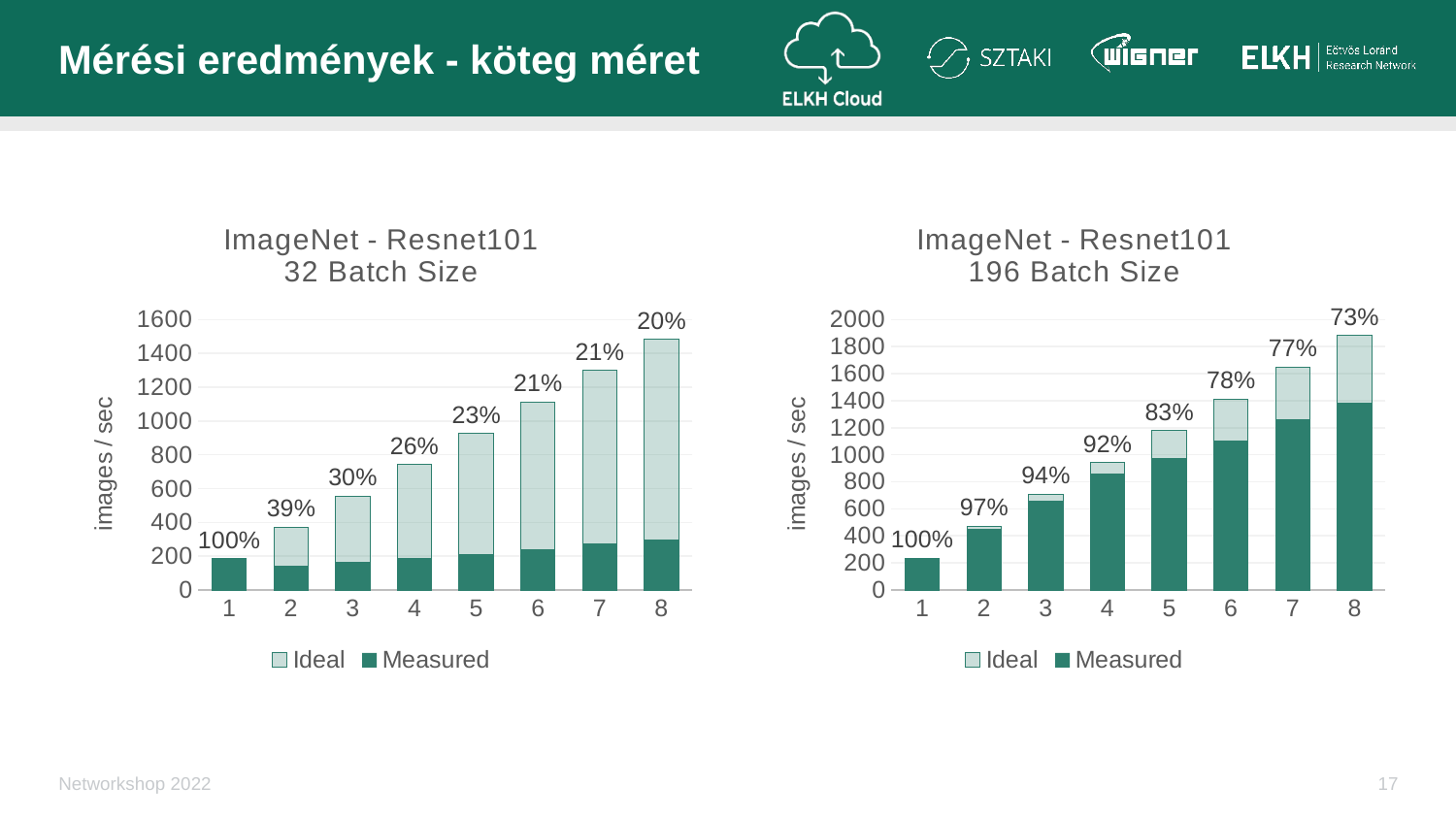
In the 'ImageNet - Resnet101 32 Batch Size' chart, do the percentage labels rise or fall as the category number increases from 1 to 8? fall In the 'ImageNet - Resnet101 196 Batch Size' chart, which has the higher percentage label, category 4 or category 6? Category 4 What kind of chart is the 'ImageNet - Resnet101 32 Batch Size' chart? Bar chart In the 'ImageNet - Resnet101 32 Batch Size' chart, what is the difference between the percentage labels for category 2 and category 3? 9% In the 'ImageNet - Resnet101 32 Batch Size' chart, what percentage label is shown above the bar for category 2? 39% What are the two legend entries in the 'ImageNet - Resnet101 196 Batch Size' chart? Ideal and Measured In the 'ImageNet - Resnet101 196 Batch Size' chart, which category has the lowest percentage label? 8 How many categories are shown on the x axis of the 'ImageNet - Resnet101 32 Batch Size' chart? 8 In the 'ImageNet - Resnet101 196 Batch Size' chart, is the Measured value for category 8 greater or less than 1200? greater In the 'ImageNet - Resnet101 196 Batch Size' chart, what percentage label is shown above the bar for category 5? 83% How many series does the legend of the 'ImageNet - Resnet101 196 Batch Size' chart list? 2 In the 'ImageNet - Resnet101 32 Batch Size' chart, is the total height of the stacked bar for category 8 greater or less than 1400? greater